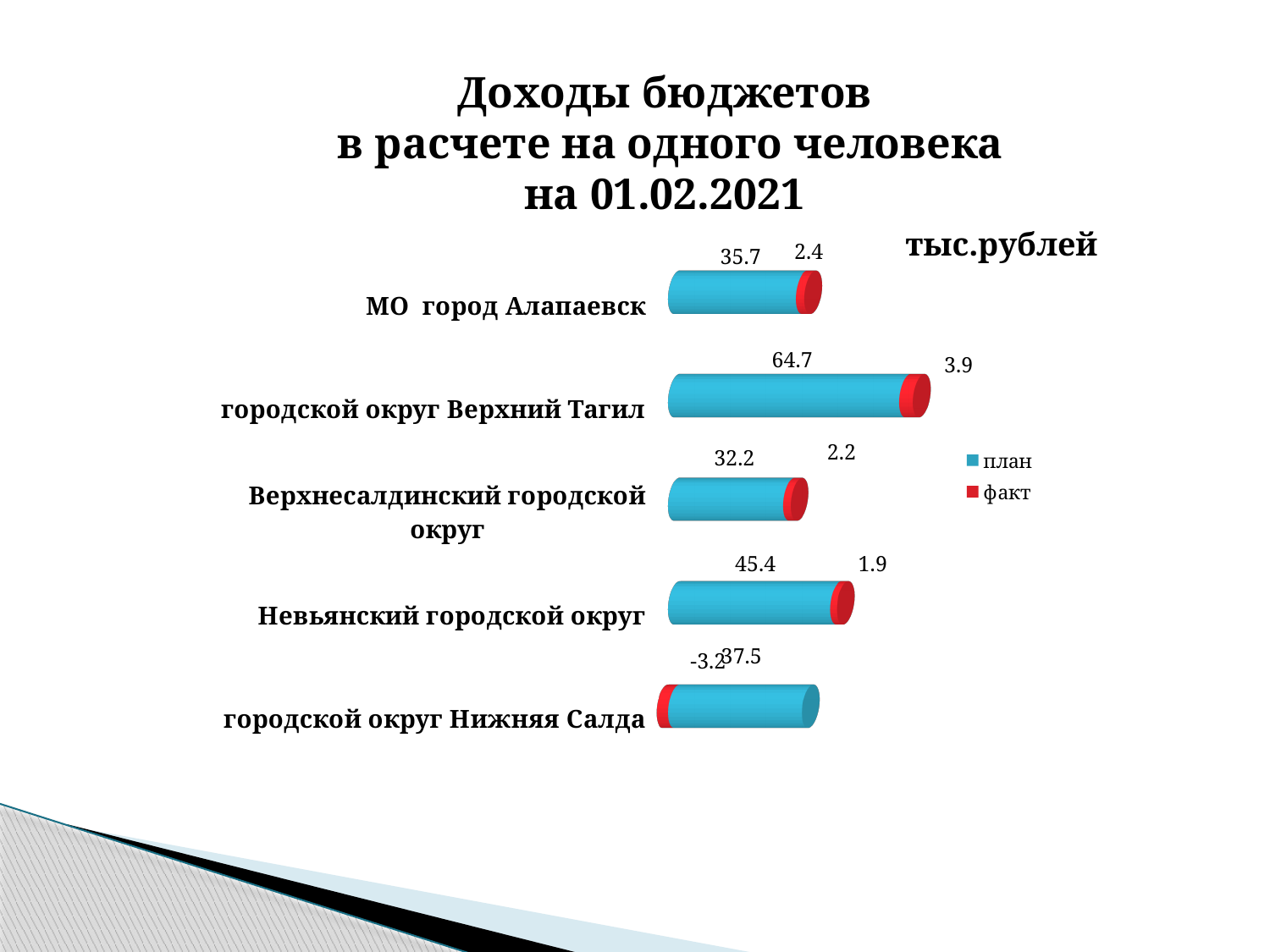
How many series does the legend list? 2 Which is larger: the план value for МО город Алапаевск or for городской округ Нижняя Салда? городской округ Нижняя Салда What is the план value for Невьянский городской округ? 45.4 What kind of chart is shown on the slide? bar chart Which category has the lowest факт value? городской округ Нижняя Салда What is the difference between the план values for городской округ Верхний Тагил and Невьянский городской округ? 19.3 What is the план value for городской округ Верхний Тагил? 64.7 What is the факт value for МО город Алапаевск? 2.4 Which category has the highest план value? городской округ Верхний Тагил What is the факт value for городской округ Нижняя Салда? -3.2 How many categories are shown in the chart? 5 Which category has the lowest план value? Верхнесалдинский городской округ